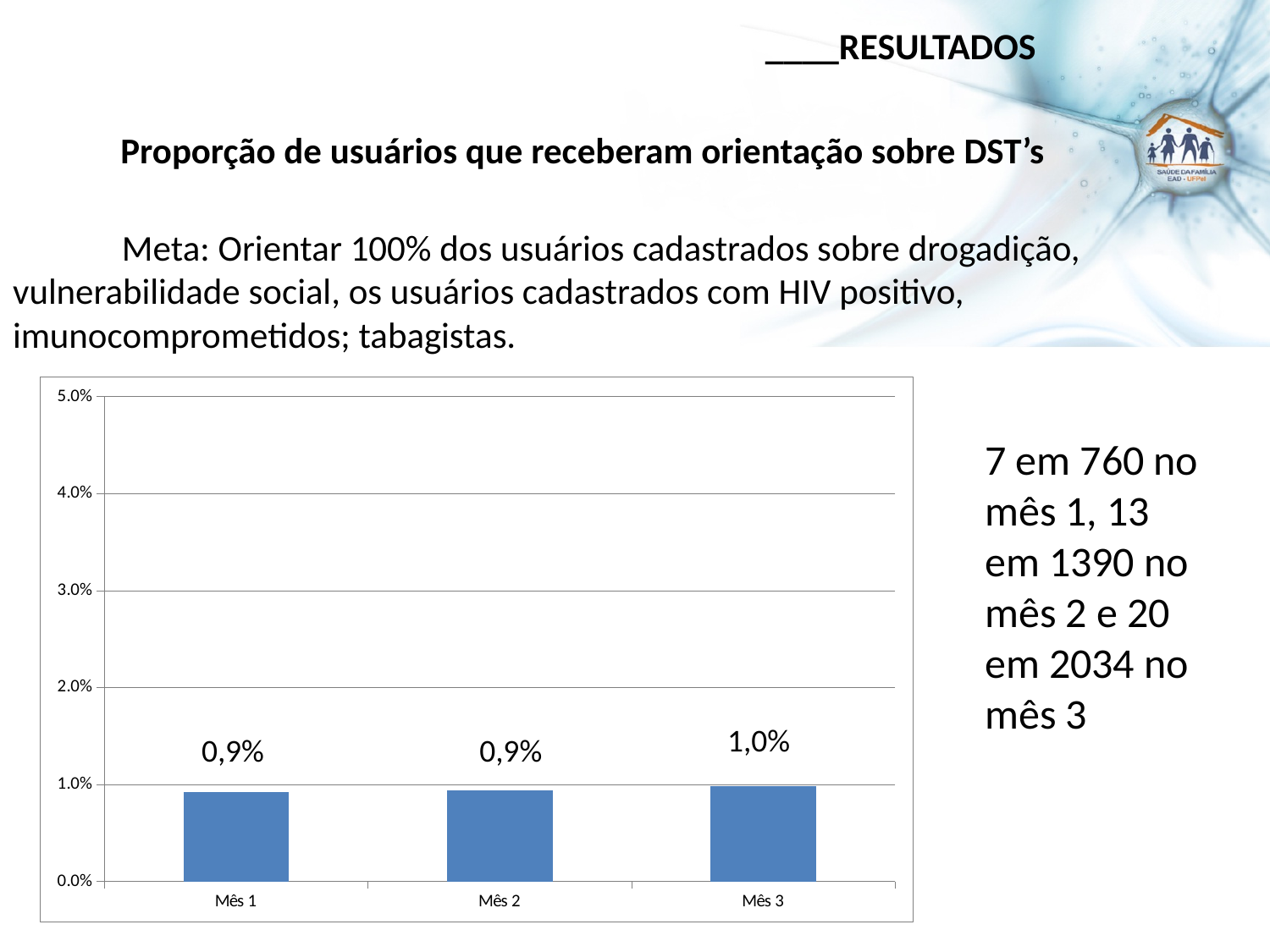
Do the values rise or fall from Mês 1 to Mês 3? rise Which month has the highest value? Mês 3 What kind of chart is shown on the slide? bar chart Which is larger, the value for Mês 3 or the value for Mês 2? Mês 3 Is the value for Mês 1 greater or less than 3.0%? less What is the value for Mês 2? 0,9% How many categories are shown on the x axis? 3 What is the highest value shown on the y axis? 5.0% What is the difference between the values for Mês 3 and Mês 1? 0,1% Is the value for Mês 3 greater or less than 2.0%? less What is the value for Mês 1? 0,9% What is the value for Mês 3? 1,0%